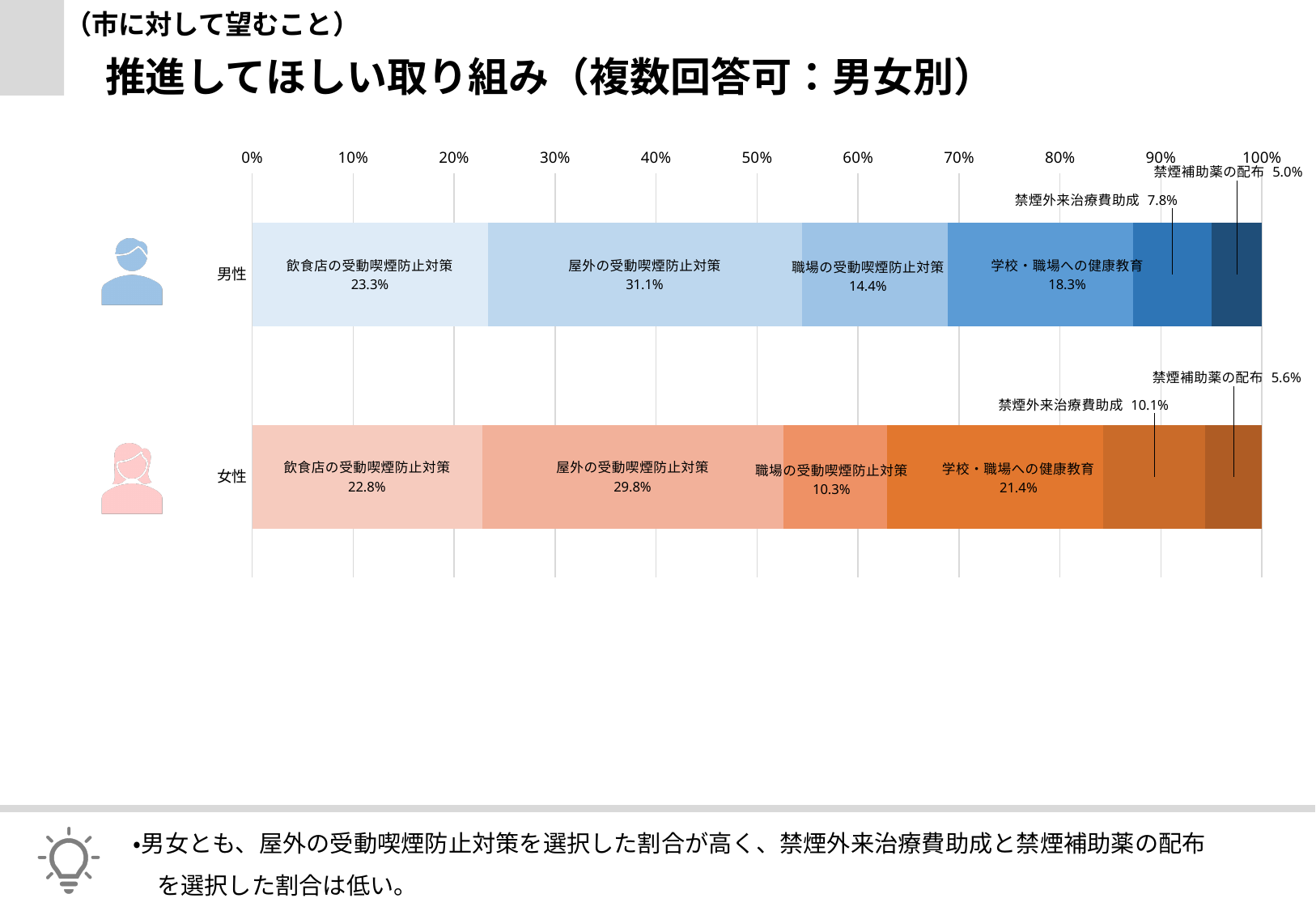
What type of chart is shown on the slide? Stacked bar chart What is the total of the 女性 bar? 100.0% Which segment is the smallest in the 男性 bar? 禁煙補助薬の配布 How many segments does each bar contain? 6 What is the value for 禁煙補助薬の配布 in the 男性 bar? 5.0% Which is larger: the 男性 value for 飲食店の受動喫煙防止対策 or the 女性 value for 飲食店の受動喫煙防止対策? 男性 What is the value for 学校・職場への健康教育 in the 女性 bar? 21.4% What is the difference between the 男性 and 女性 values for 職場の受動喫煙防止対策? 4.1% Which segment is the largest in the 女性 bar? 屋外の受動喫煙防止対策 How many bars (categories) are shown in the chart? 2 What is the value for 禁煙外来治療費助成 in the 女性 bar? 10.1% What is the value for 屋外の受動喫煙防止対策 in the 男性 bar? 31.1%